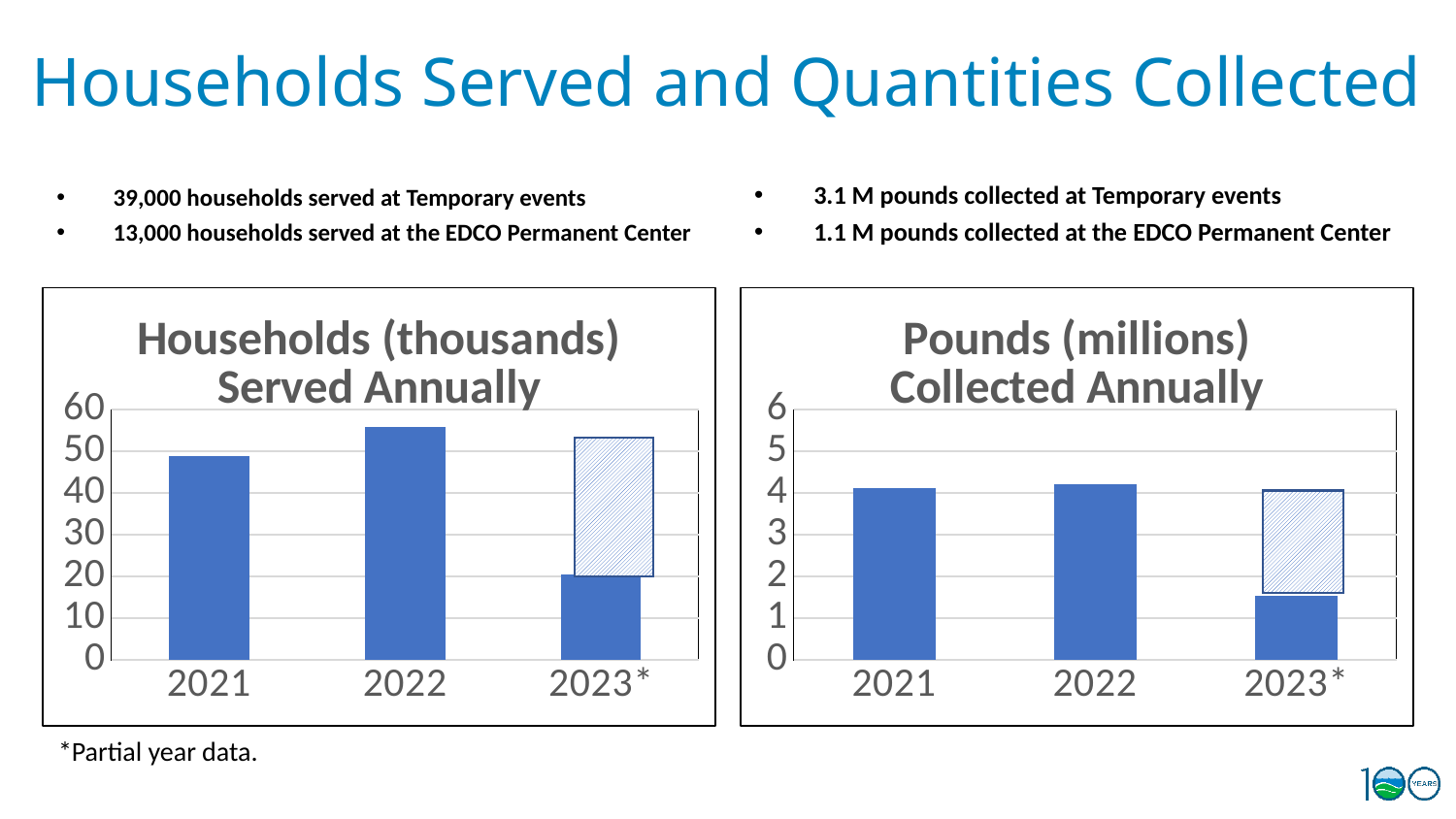
In the 'Pounds (millions) Collected Annually' chart, is the solid bar for 2023* greater or less than 2? less What kind of chart is the 'Households (thousands) Served Annually' chart? bar chart In the 'Households (thousands) Served Annually' chart, which year has the shortest solid bar? 2023* What does the asterisk on 2023* indicate, according to the note below the charts? Partial year data How many years are shown on the x axis of the 'Pounds (millions) Collected Annually' chart? 3 In the 'Households (thousands) Served Annually' chart, is the solid bar for 2023* greater or less than 30? less In the 'Pounds (millions) Collected Annually' chart, is the value for 2021 greater or less than 3? greater In the 'Households (thousands) Served Annually' chart, is the solid bar for 2021 or 2022 taller? 2022 In the 'Households (thousands) Served Annually' chart, which year has the tallest solid bar? 2022 In the 'Pounds (millions) Collected Annually' chart, which year has the shortest solid bar? 2023*